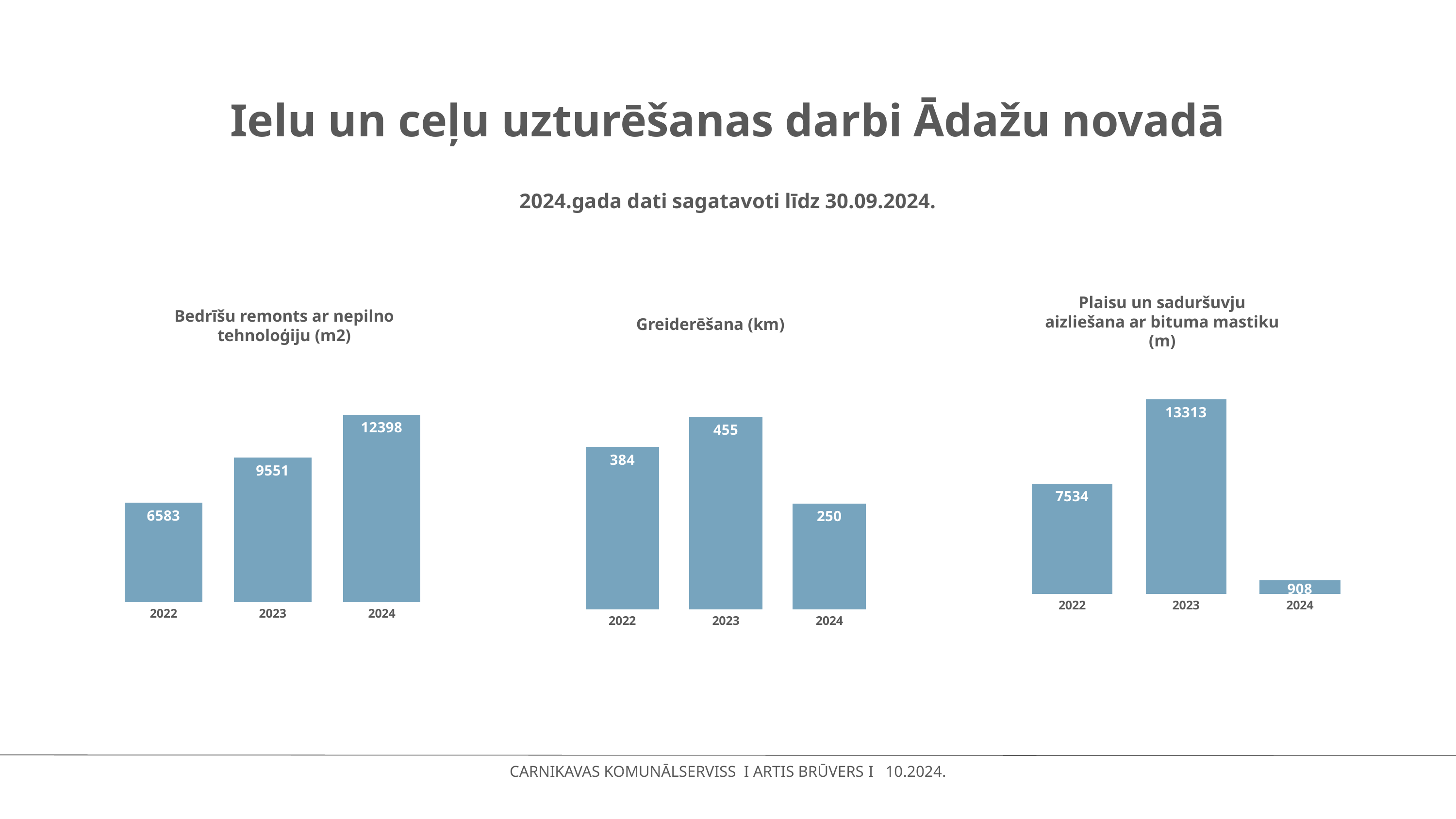
How many charts are shown on the slide? 3 In the chart titled 'Bedrīšu remonts ar nepilno tehnoloģiju (m2)', what is the value for 2024? 12398 In the chart titled 'Plaisu un saduršuvju aizliešana ar bituma mastiku (m)', what is the difference between the 2023 and 2022 values? 5779 In the chart titled 'Greiderēšana (km)', what is the value for 2022? 384 In the chart titled 'Bedrīšu remonts ar nepilno tehnoloģiju (m2)', which is larger, the value for 2023 or the value for 2024? 2024 How many bars are in the chart titled 'Greiderēšana (km)'? 3 In the chart titled 'Bedrīšu remonts ar nepilno tehnoloģiju (m2)', which year has the lowest value? 2022 In the chart titled 'Plaisu un saduršuvju aizliešana ar bituma mastiku (m)', what is the value for 2024? 908 In the chart titled 'Greiderēšana (km)', what is the difference between the 2023 and 2024 values? 205 In the chart titled 'Bedrīšu remonts ar nepilno tehnoloģiju (m2)', do the values rise or fall from 2022 to 2024? rise What kind of chart is the chart titled 'Plaisu un saduršuvju aizliešana ar bituma mastiku (m)'? bar chart In the chart titled 'Greiderēšana (km)', which year has the highest value? 2023